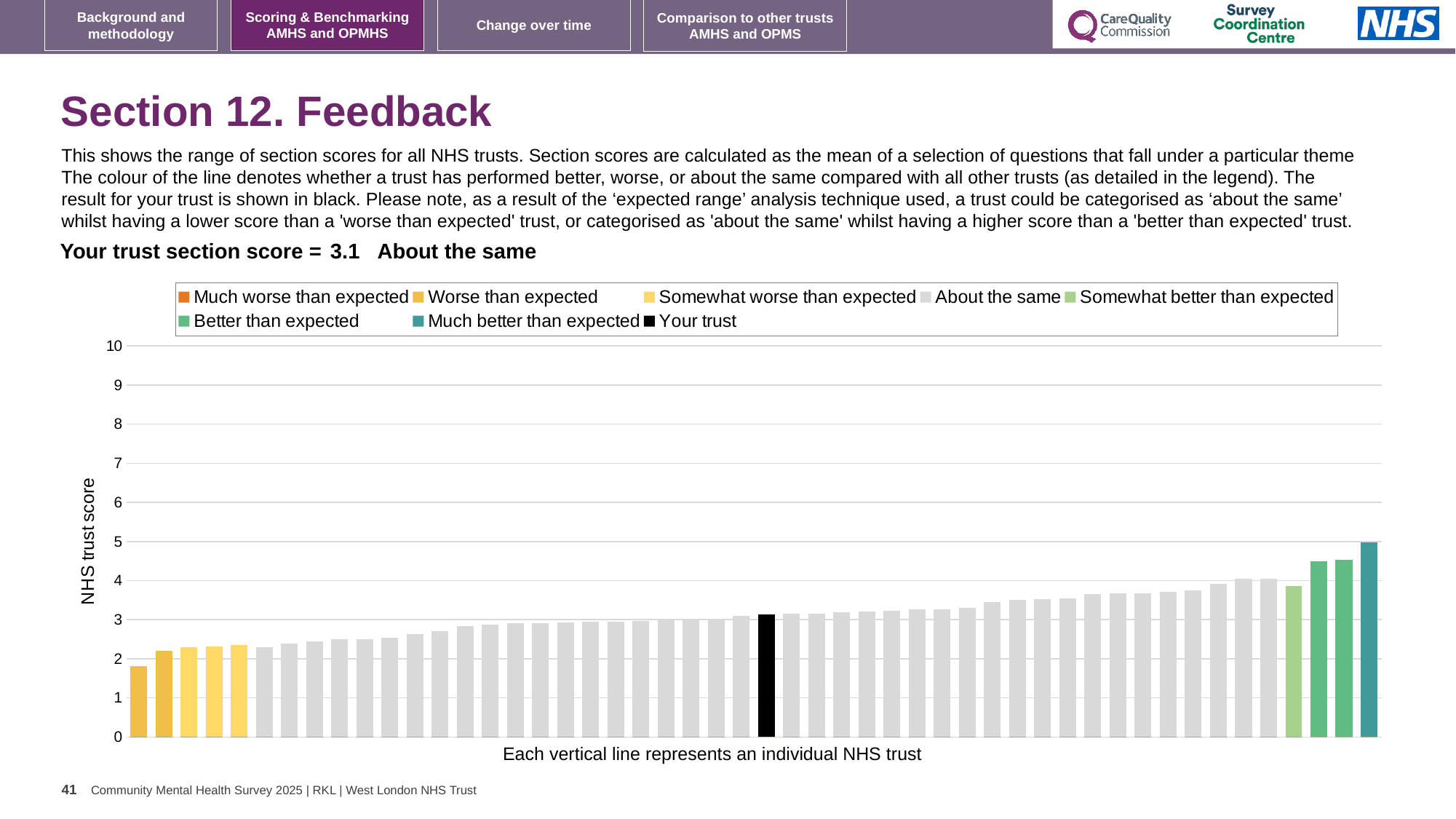
What is the section score for your trust shown on the slide? 3.1 How many entries does the chart legend list? 8 Is the value of the tallest bar greater or less than 4? greater What is the label on the vertical axis of the chart? NHS trust score Which legend category does the tallest bar belong to? Much better than expected Is the value of the shortest bar greater or less than 3? less Do the bar values rise or fall from left to right along the x axis? rise What colour is the bar representing your trust? black Which category is your trust's section score placed in? About the same Is the value of the tallest bar greater or less than 6? less What kind of chart is shown on the slide? bar chart